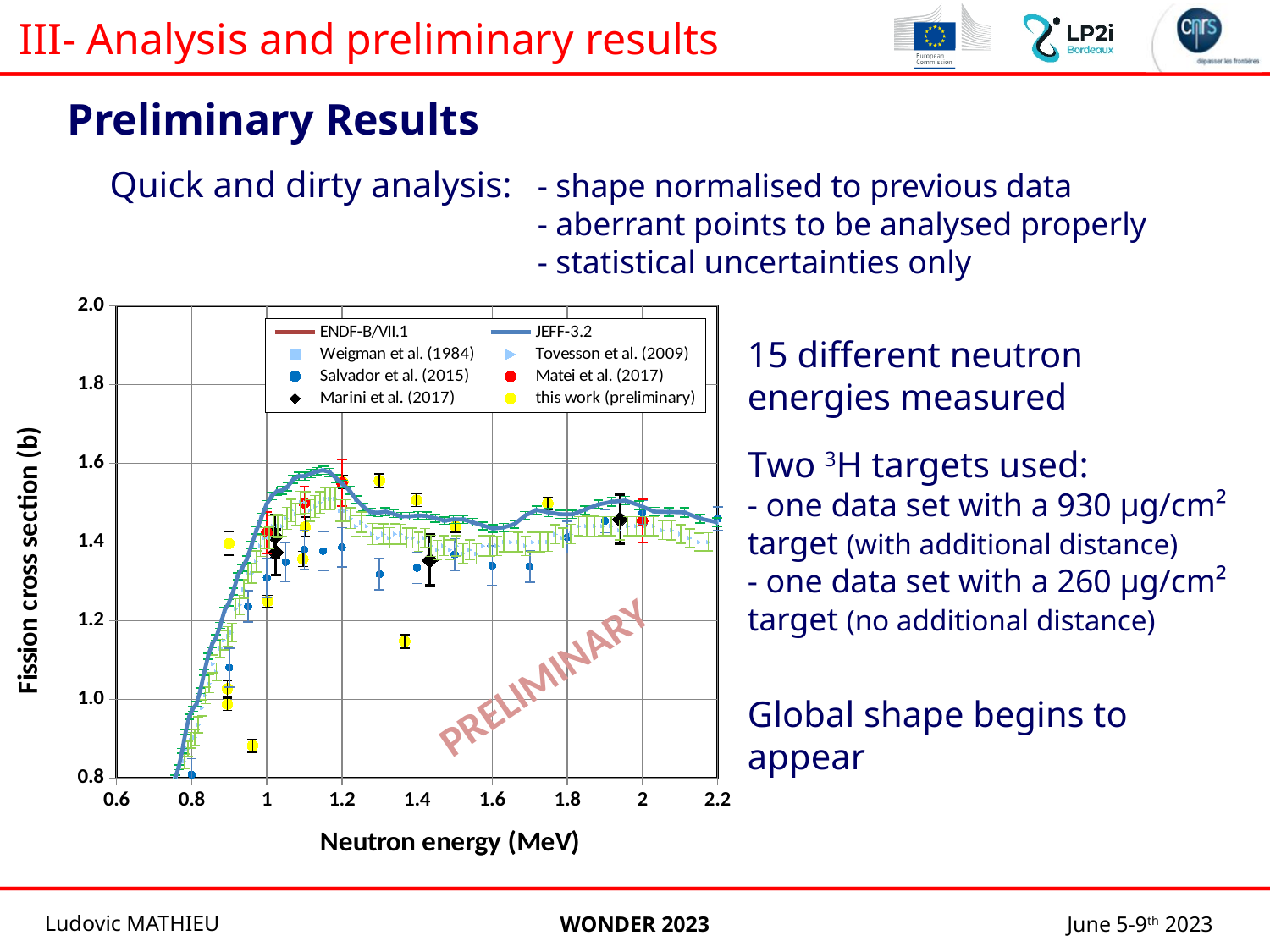
Which legend entry corresponds to the yellow points on the chart? this work (preliminary) Which is larger: the yellow point near 1.3 MeV or the yellow point near 1.37 MeV? the point near 1.3 MeV What is the label of the y axis of the chart? Fission cross section (b) Which of the two evaluated curves in the legend is drawn in blue? JEFF-3.2 What kind of chart is shown on the slide? Scatter chart with lines What is the maximum value shown on the y axis of the chart? 2.0 How many series does the chart legend list? 8 Between 0.8 MeV and 1.0 MeV, do the evaluated curves (ENDF-B/VII.1 and JEFF-3.2) rise or fall with increasing neutron energy? rise Is the yellow 'this work (preliminary)' point near 1.37 MeV greater or less than 1.2 b? less Is the yellow 'this work (preliminary)' point near 1.3 MeV greater or less than 1.4 b? greater Is the lowest yellow 'this work (preliminary)' point, near 0.95 MeV, greater or less than 1.0 b? less